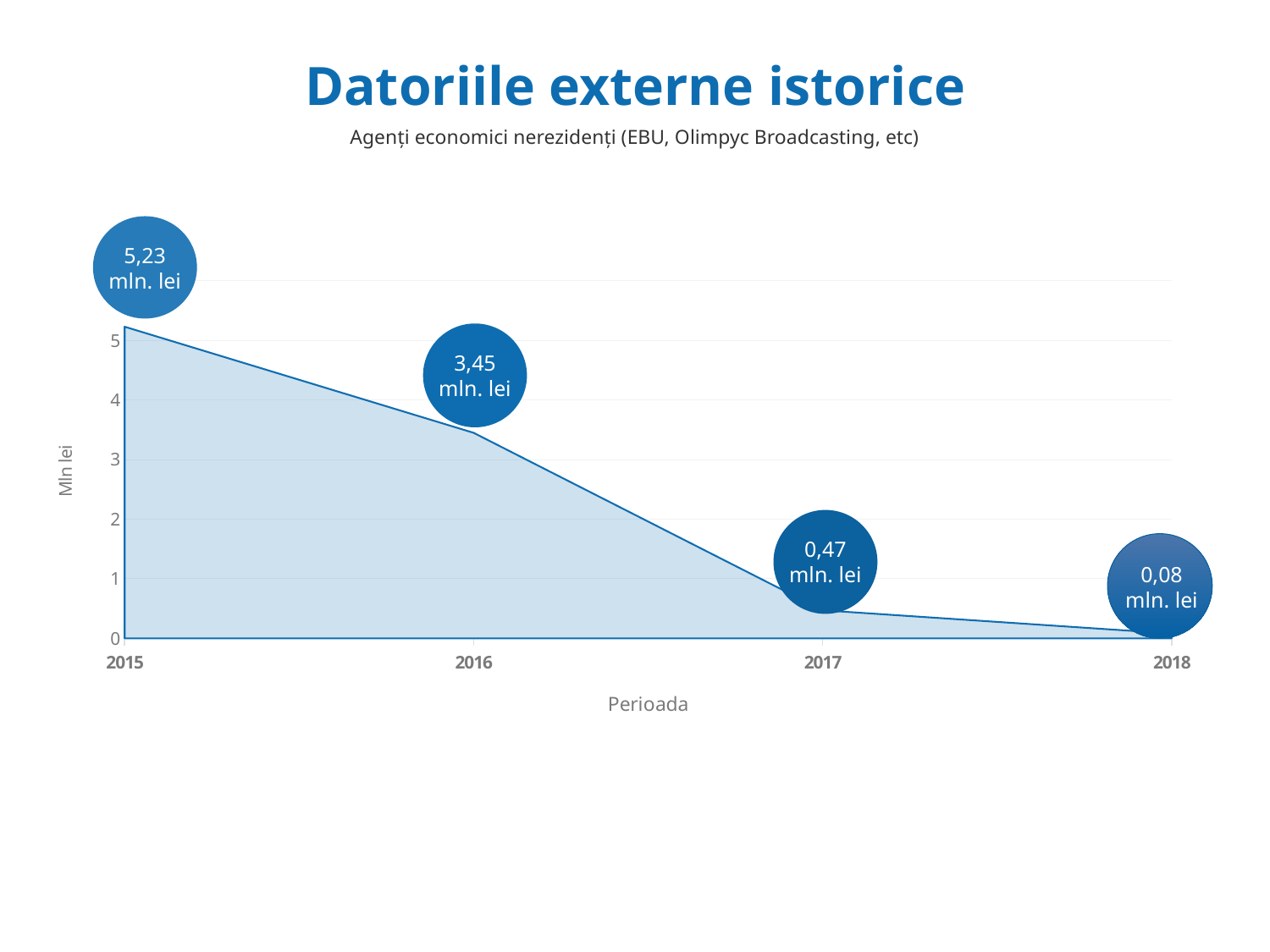
Is the value for 2016 greater or less than 3? greater What kind of chart is shown on the slide? Area chart Which is larger, the value for 2016 or the value for 2017? 2016 What is the value for 2016? 3,45 mln. lei How many years are plotted on the chart? 4 Do the values rise or fall from 2015 to 2018? Fall What is the difference between the values for 2015 and 2016? 1,78 mln. lei Which year has the highest value? 2015 Which year has the lowest value? 2018 What is the value for 2018? 0,08 mln. lei What is the value for 2015? 5,23 mln. lei What is the value for 2017? 0,47 mln. lei